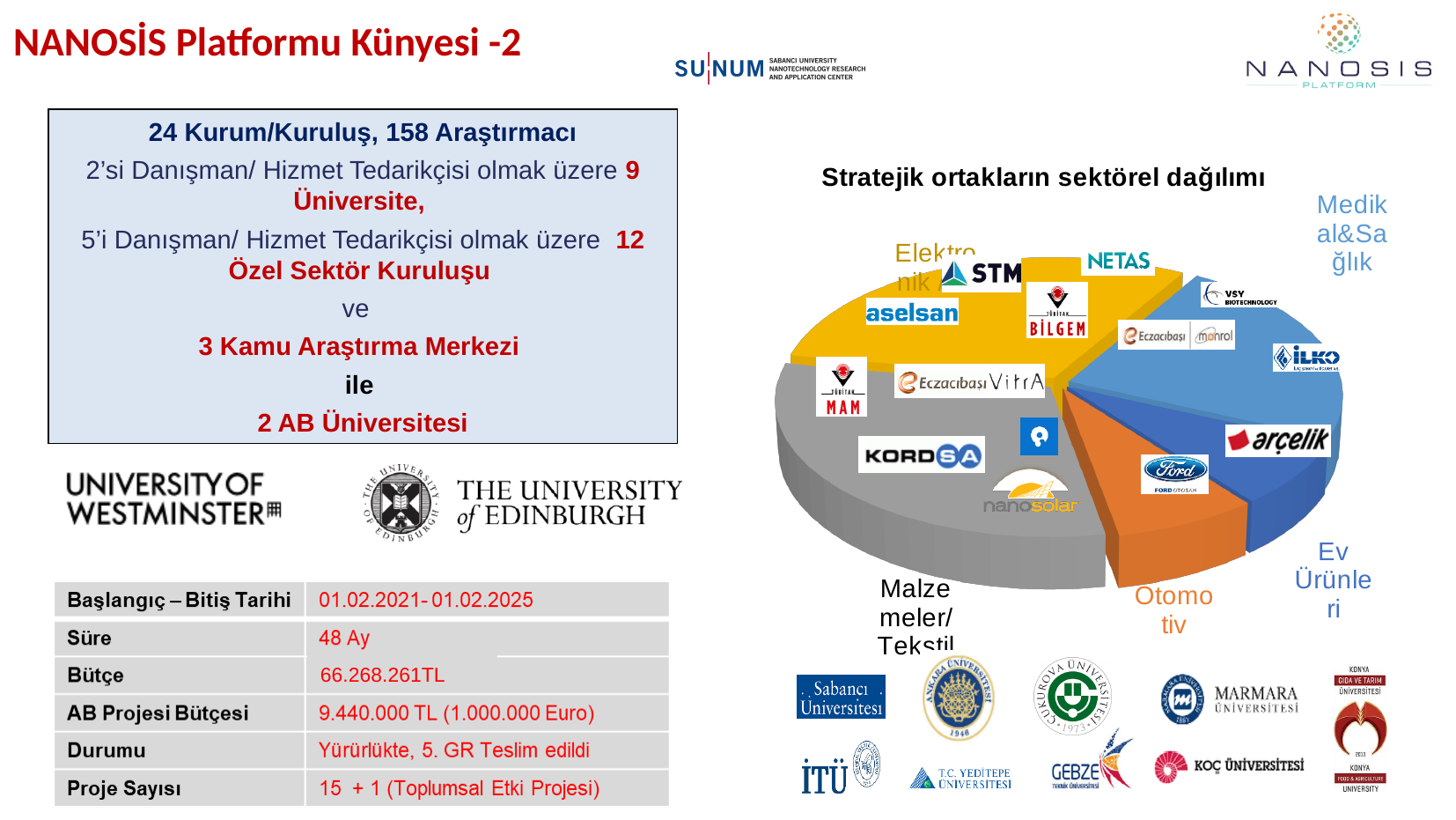
In the pie chart, which slice is larger: Malzemeler/Tekstil or Otomotiv? Malzemeler/Tekstil What kind of chart is used to show the sectoral distribution of strategic partners? Pie chart Which colour represents the Otomotiv slice in the pie chart? Orange In the pie chart, which slice is larger: Medikal&Sağlık or Ev Ürünleri? Medikal&Sağlık What is the title of the pie chart on the slide? Stratejik ortakların sektörel dağılımı In the pie chart, which slice is larger: Elektronik or Ev Ürünleri? Elektronik How many sectors are shown as slices in the pie chart? 5